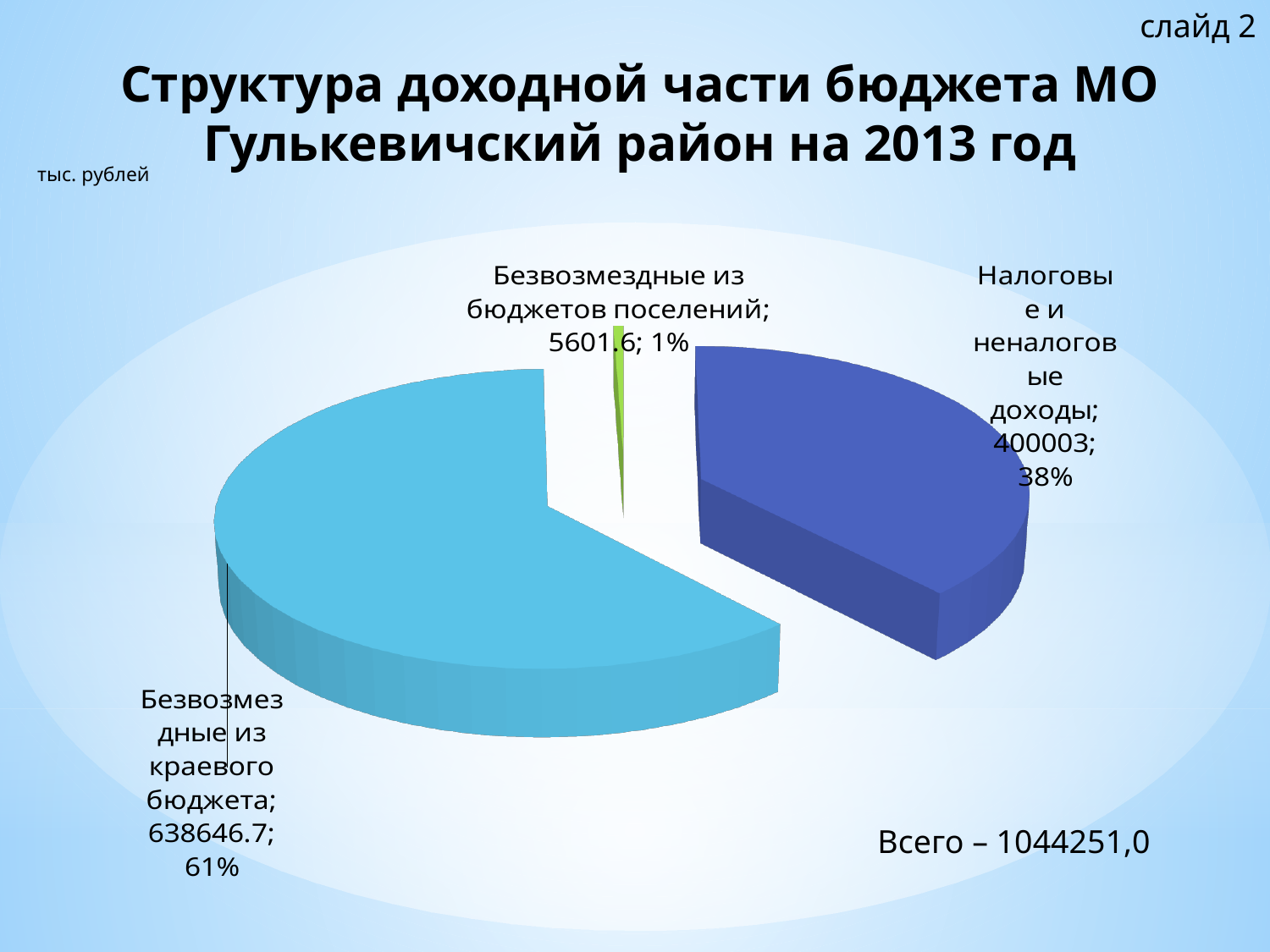
What total (Всего) is stated on the slide? 1044251,0 What share of the pie does Безвозмездные из краевого бюджета represent? 61% Which is larger: Налоговые и неналоговые доходы or Безвозмездные из краевого бюджета? Безвозмездные из краевого бюджета What is the value for Налоговые и неналоговые доходы? 400003 How many slices does the pie chart have? 3 Which category has the smallest slice of the pie? Безвозмездные из бюджетов поселений What share of the pie does Безвозмездные из бюджетов поселений represent? 1% What is the value for Безвозмездные из бюджетов поселений? 5601.6 What kind of chart is shown on the slide? Pie chart Which category has the largest slice of the pie? Безвозмездные из краевого бюджета What is the value for Безвозмездные из краевого бюджета? 638646.7 What share of the pie does Налоговые и неналоговые доходы represent? 38%